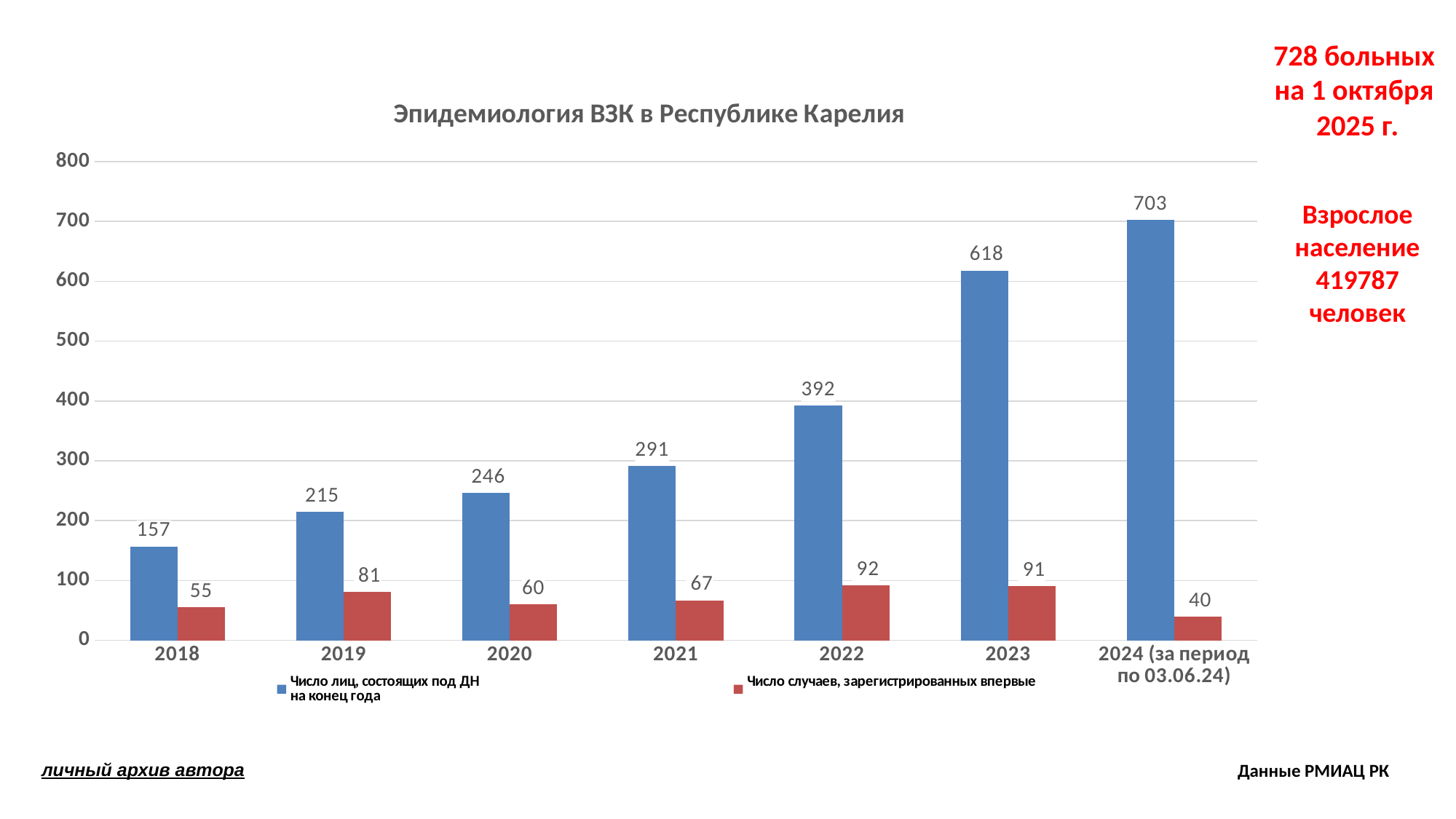
What is the value of 'Число случаев, зарегистрированных впервые' for 2019? 81 Which year has the lowest value for 'Число лиц, состоящих под ДН на конец года'? 2018 How many years are shown on the x axis? 7 How many series does the legend list? 2 Is the value of 'Число лиц, состоящих под ДН на конец года' for 2022 greater or less than 400? less What kind of chart is shown on the slide? bar chart What is the difference between the 'Число лиц, состоящих под ДН на конец года' values for 2023 and 2022? 226 Which year has the highest value for 'Число случаев, зарегистрированных впервые'? 2022 What is the value of 'Число лиц, состоящих под ДН на конец года' for 2024 (за период по 03.06.24)? 703 What is the value of 'Число лиц, состоящих под ДН на конец года' for 2021? 291 Which is larger: 'Число случаев, зарегистрированных впервые' in 2020 or in 2021? 2021 Does 'Число лиц, состоящих под ДН на конец года' rise or fall from 2018 to 2024? rise